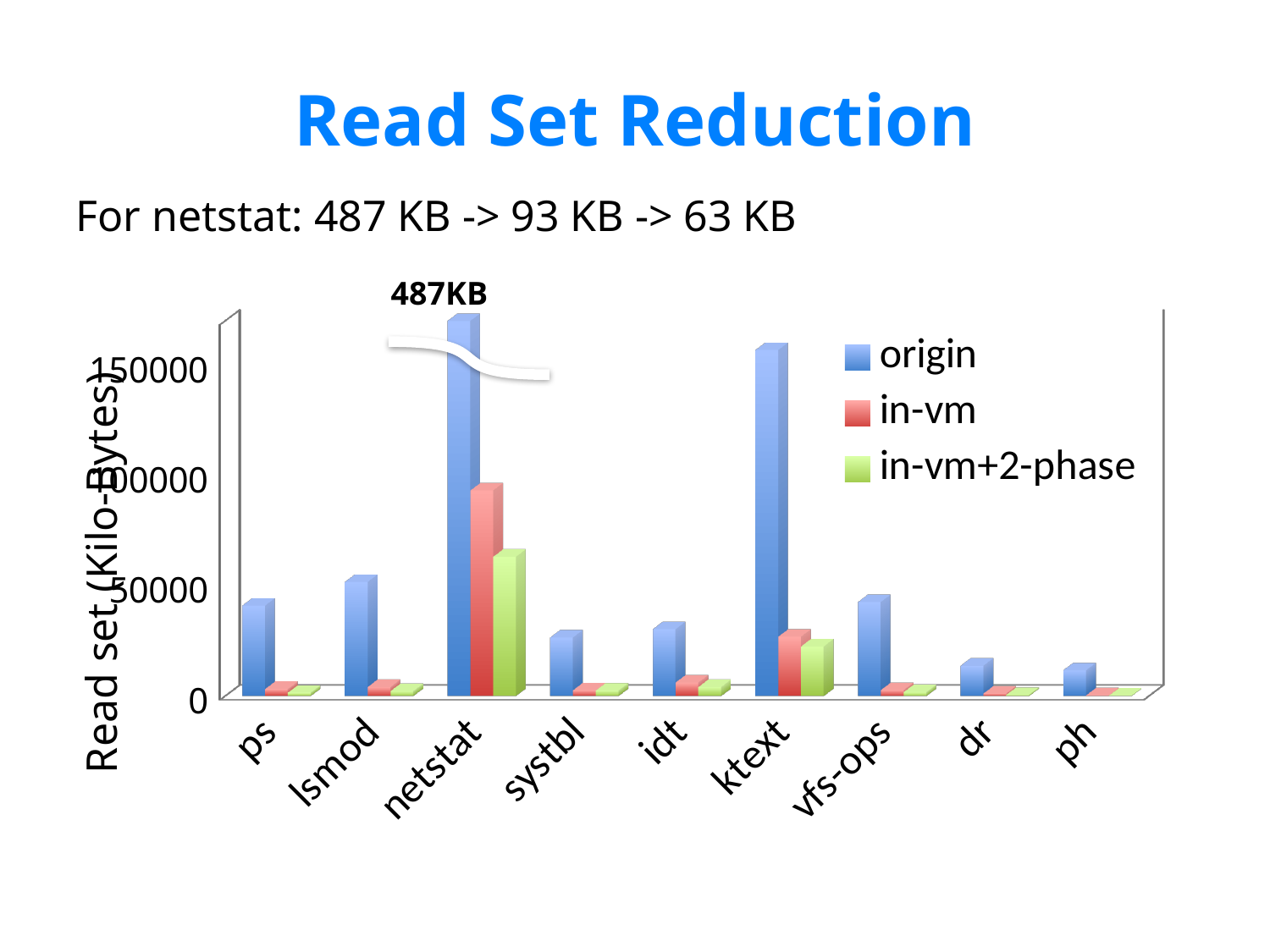
How many series does the legend list? 3 How many categories are shown on the x axis? 9 Which is larger, the origin value for ktext or the origin value for lsmod? ktext Which is larger, the in-vm value for netstat or the in-vm value for ktext? netstat Is the in-vm+2-phase value for netstat greater or less than 50000? greater Is the origin value for systbl greater or less than 50000? less What kind of chart is shown on the slide? bar chart What value is labelled on the origin bar for netstat? 487KB What is the title of the y axis? Read set (Kilo-Bytes) Which category has the highest origin value? netstat Is the origin value for ktext greater or less than 150000? greater